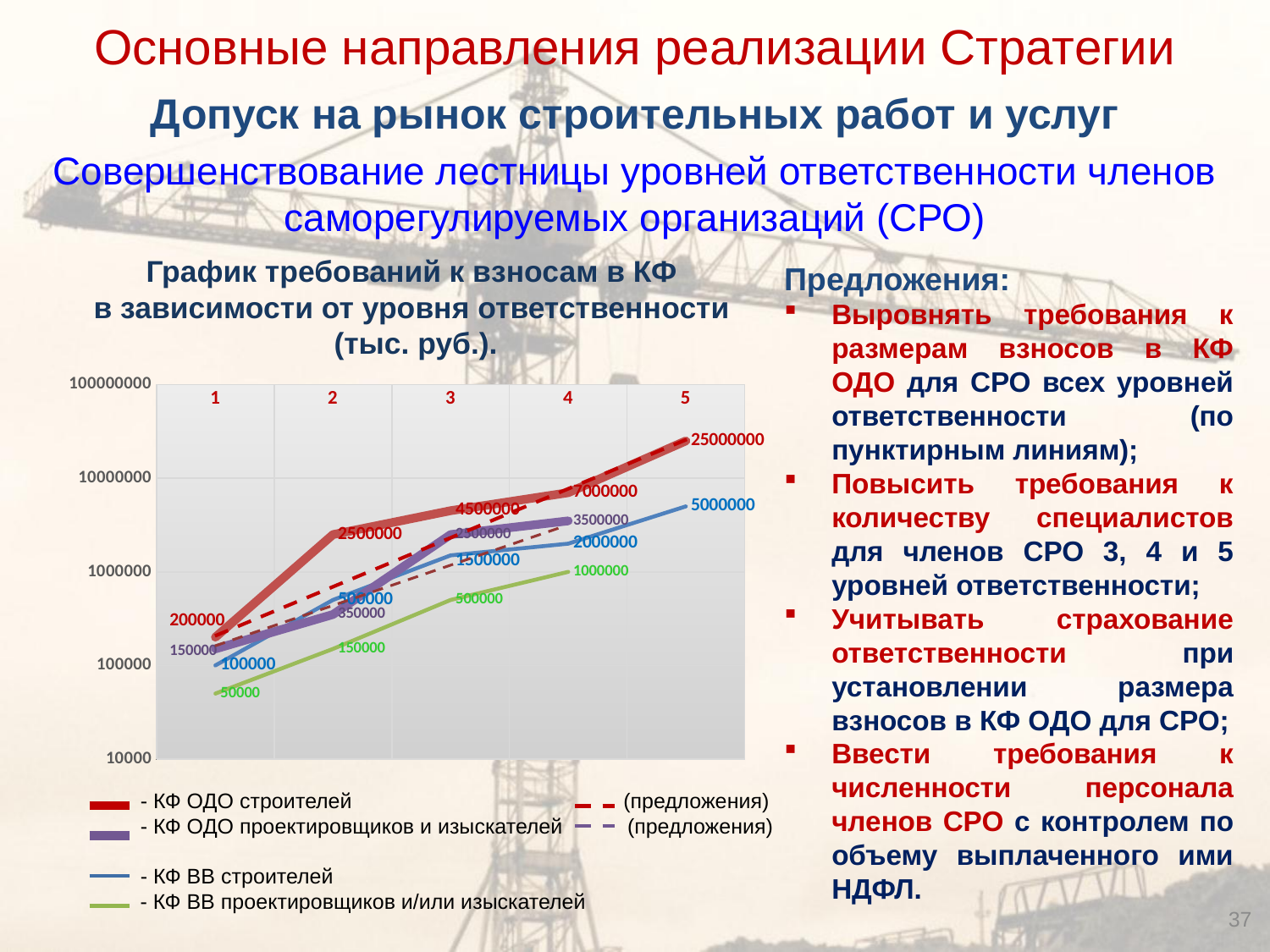
What is the value for КФ ОДО строителей at level 1? 200000 Do the values for КФ ВВ строителей rise or fall from level 1 to level 5? rise What is the difference between the КФ ОДО строителей values at level 5 and level 4? 18000000 At which level is the value for КФ ВВ строителей lowest? 1 Which is larger at level 3: КФ ОДО строителей or КФ ВВ строителей? КФ ОДО строителей What is the value for КФ ВВ строителей at level 5? 5000000 What is the value for КФ ВВ проектировщиков и/или изыскателей at level 1? 50000 At which level is the value for КФ ОДО строителей highest? 5 What is the value for КФ ОДО строителей at level 5? 25000000 What is the value for КФ ОДО проектировщиков и изыскателей at level 4? 3500000 What kind of chart is shown on the slide? line chart How many responsibility levels are shown on the x axis? 5